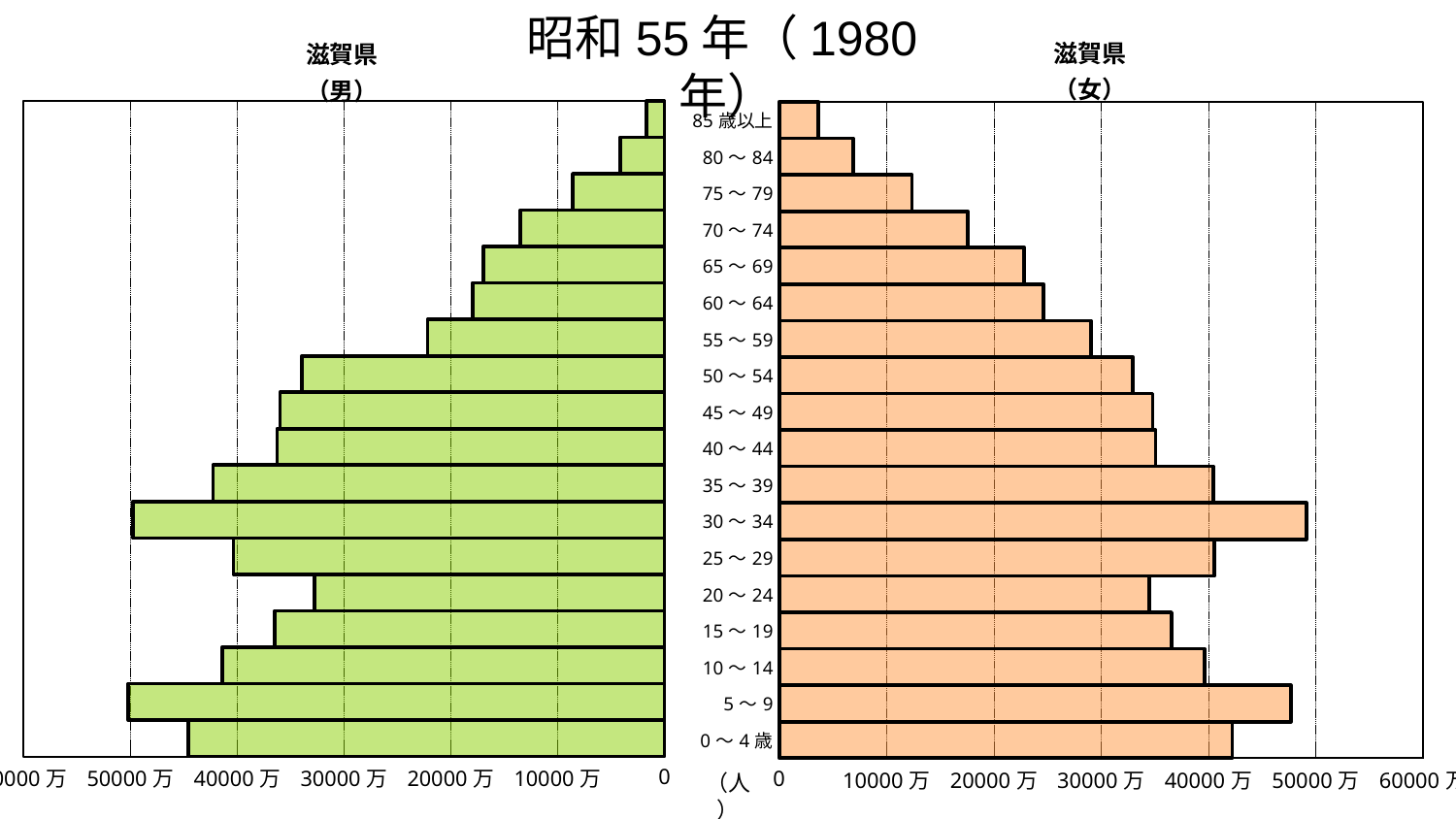
On the left chart (滋賀県（男）), which is larger, the value for 30～34 or the value for 20～24? 30～34 On the left chart (滋賀県（男）), is the value for 85歳以上 greater or less than 10000万? less On the right chart (滋賀県（女）), is the value for 5～9 greater or less than 40000万? greater What colour are the bars on the right chart (滋賀県（女）)? orange On the right chart (滋賀県（女）), which age group has the lowest value? 85歳以上 On the right chart (滋賀県（女）), is the value for 70～74 greater or less than 20000万? less What is the main title shown above the two charts? 昭和55年（1980年） How many age groups are shown on the right chart (滋賀県（女）)? 18 What kind of chart is the left chart (滋賀県（男）)? bar chart On the right chart (滋賀県（女）), which is larger, the value for 0～4歳 or the value for 85歳以上? 0～4歳 On the left chart (滋賀県（男）), which age group has the lowest value? 85歳以上